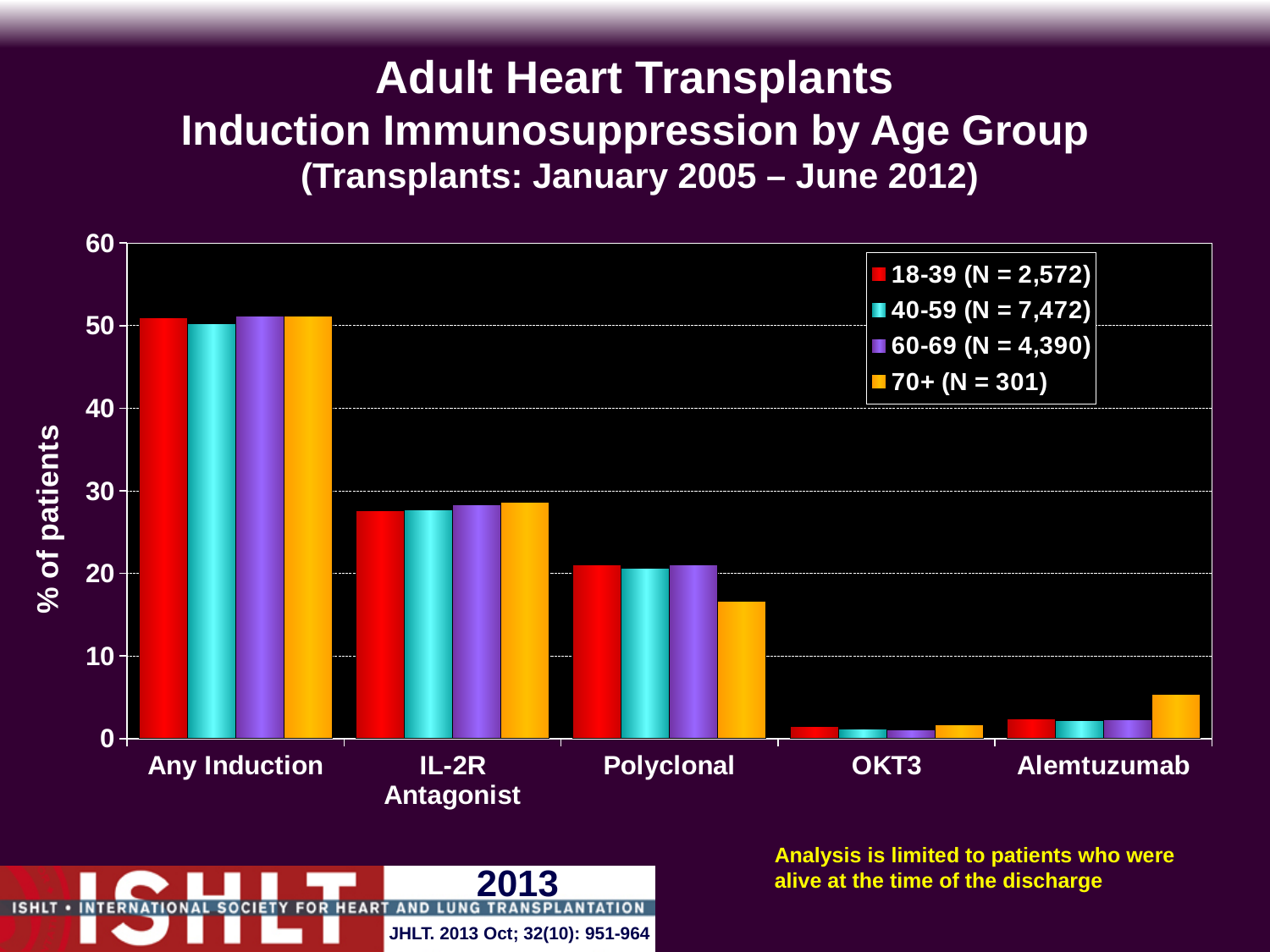
How many age-group series does the legend list? 4 According to the legend, what is the N for the 40-59 age group? 7,472 What is the label of the y axis? % of patients How many induction categories are shown along the x axis? 5 For Polyclonal, which is larger: the 18-39 age group or the 70+ age group? 18-39 For Alemtuzumab, which is larger: the 70+ age group or the 18-39 age group? 70+ Is the value for Any Induction in the 18-39 age group greater or less than 40? greater Which induction category has the highest value for the 70+ age group? Any Induction Is the value for Polyclonal in the 70+ age group greater or less than 20? less Is the value for IL-2R Antagonist in the 70+ age group greater or less than 30? less What kind of chart is shown on the slide? bar chart Which age group has the highest value for Alemtuzumab? 70+